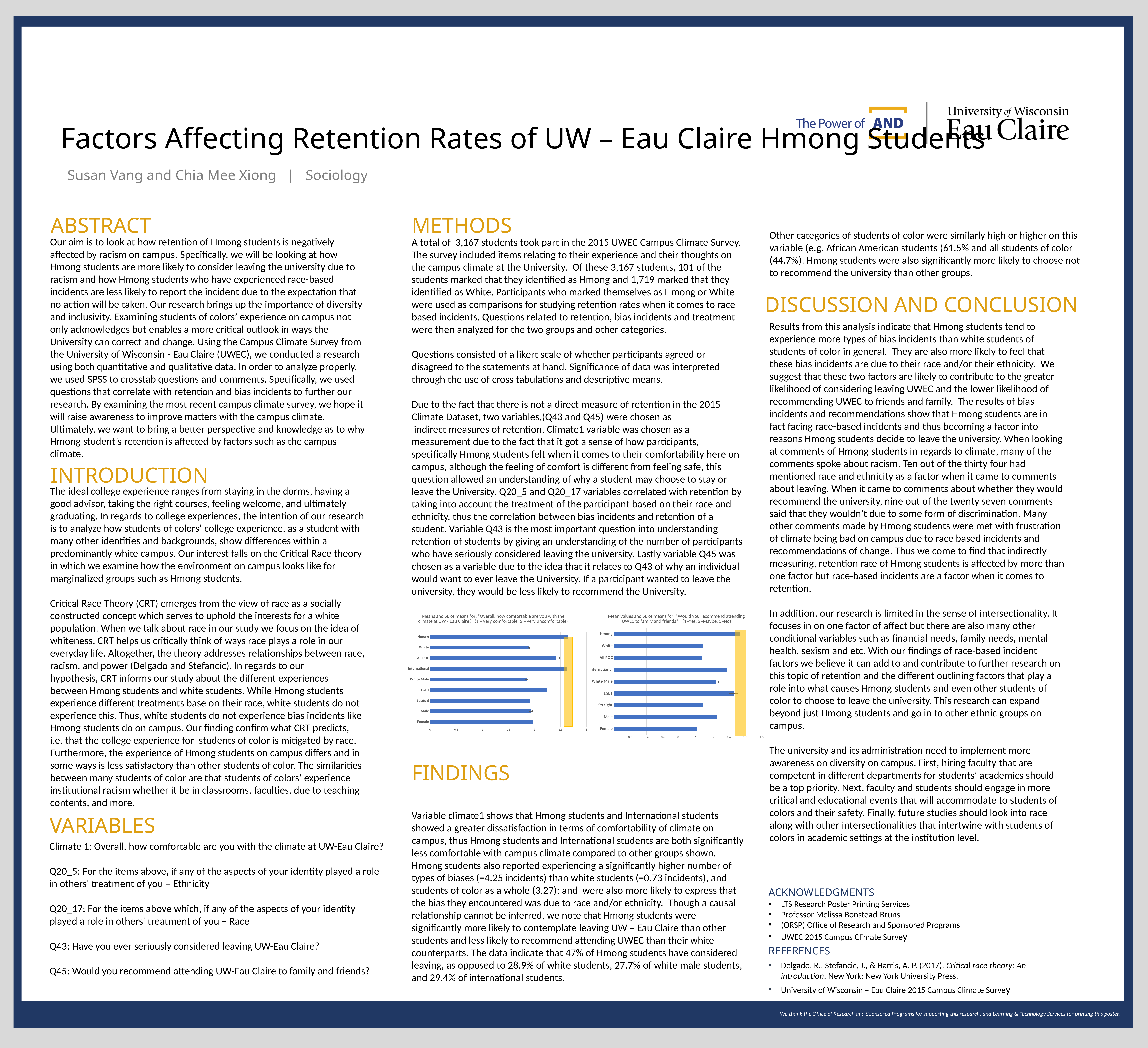
In the right chart about recommending attending UWEC, is the value for Female greater or less than 1.2? less In the right chart about recommending attending UWEC, is the value for Hmong greater or less than 1.2? greater How many categories are plotted in the right chart about recommending attending UWEC to family and friends? 9 What kind of chart is the left chart about comfort with the climate at UW - Eau Claire? bar chart In the left chart about comfort with the climate, which is larger, the value for Hmong or the value for White? Hmong According to the left chart's title, what does a value of 5 mean on the comfort scale? very uncomfortable In the left chart about comfort with the climate, is the value for White greater or less than 2.5? less How many categories are plotted in the left chart about comfort with the climate at UW - Eau Claire? 9 In the right chart about recommending attending UWEC, which is larger, the value for LGBT or the value for Straight? LGBT In the right chart about recommending attending UWEC, which is larger, the value for Hmong or the value for White? Hmong